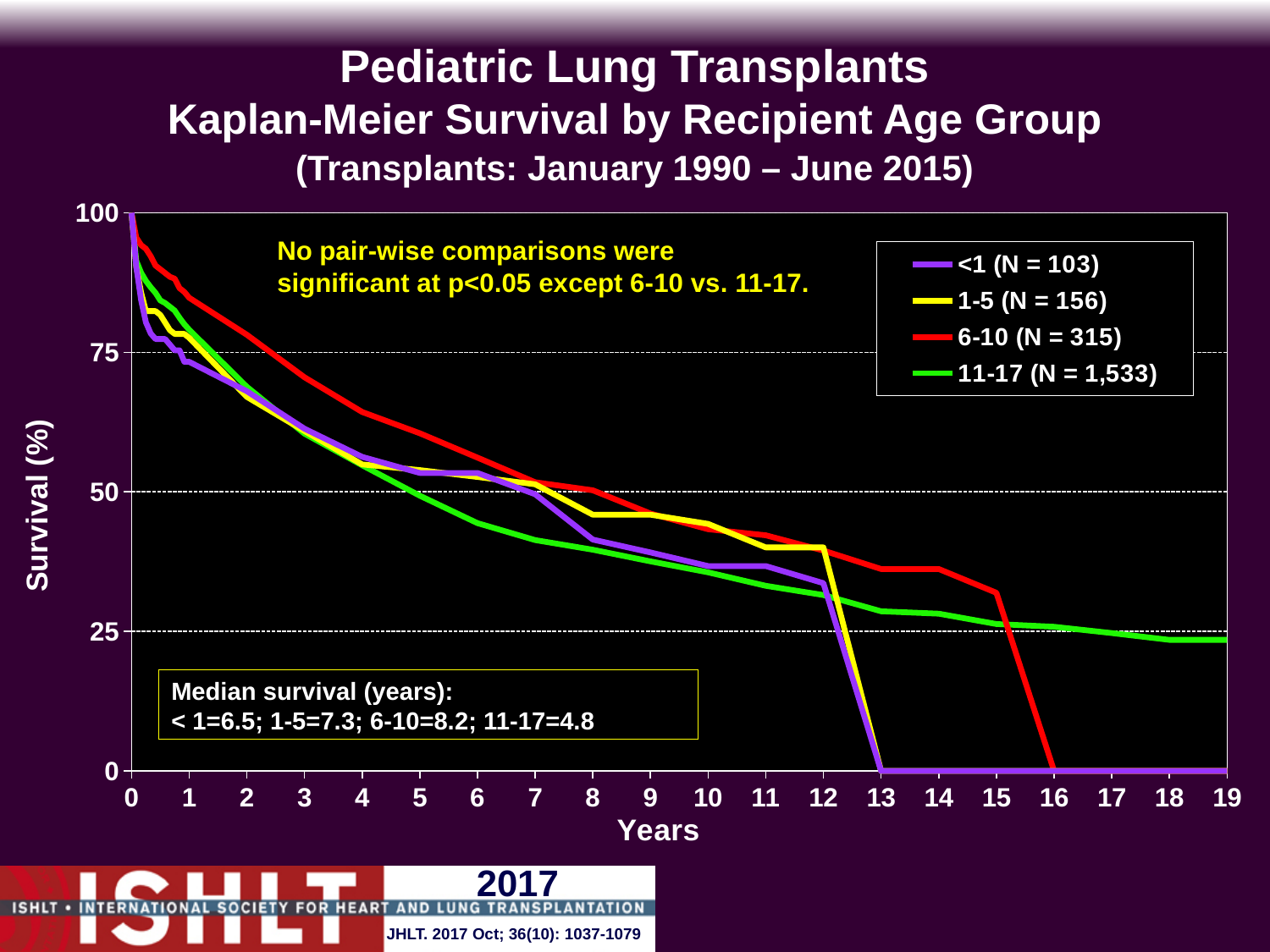
Which age group has a larger N, 1-5 or 6-10? 6-10 What is the difference in median survival (years) between the 6-10 group and the 11-17 group? 3.4 What is the median survival in years for the 11-17 age group? 4.8 Which age group has the highest median survival? 6-10 What is the N for the 11-17 age group shown in the legend? 1,533 Which age group has the lowest median survival? 11-17 Do the survival curves rise or fall as years increase? fall What kind of chart is shown on the slide? line chart How many series does the legend list? 4 What is the N for the 6-10 age group shown in the legend? 315 Is the survival value for the 11-17 group at 10 years greater or less than 50? less What colour is the line for the 11-17 age group? green